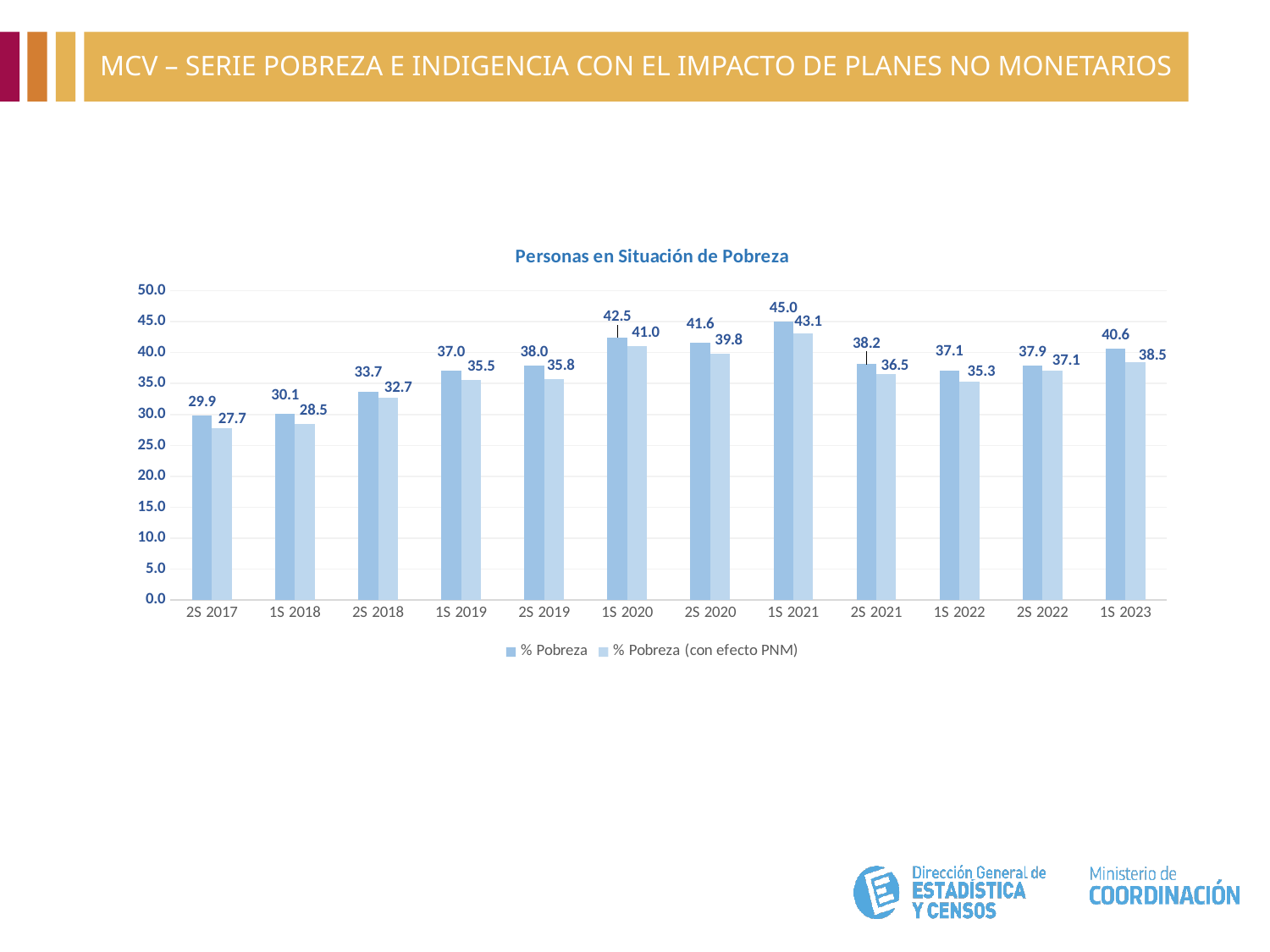
Which period has the lowest % Pobreza (con efecto PNM) value? 2S 2017 Which period has the highest % Pobreza value? 1S 2021 What is the title of the chart? Personas en Situación de Pobreza How many series does the legend list? 2 What kind of chart is shown? bar chart Which is larger: % Pobreza for 2S 2020 or % Pobreza for 1S 2023? 2S 2020 What is the value of % Pobreza (con efecto PNM) for 1S 2023? 38.5 What is the value of % Pobreza for 1S 2021? 45.0 What is the value of % Pobreza (con efecto PNM) for 2S 2017? 27.7 How many periods are shown on the x axis? 12 Is the % Pobreza value for 2S 2018 greater or less than 35.0? less What is the difference between % Pobreza and % Pobreza (con efecto PNM) for 1S 2020? 1.5